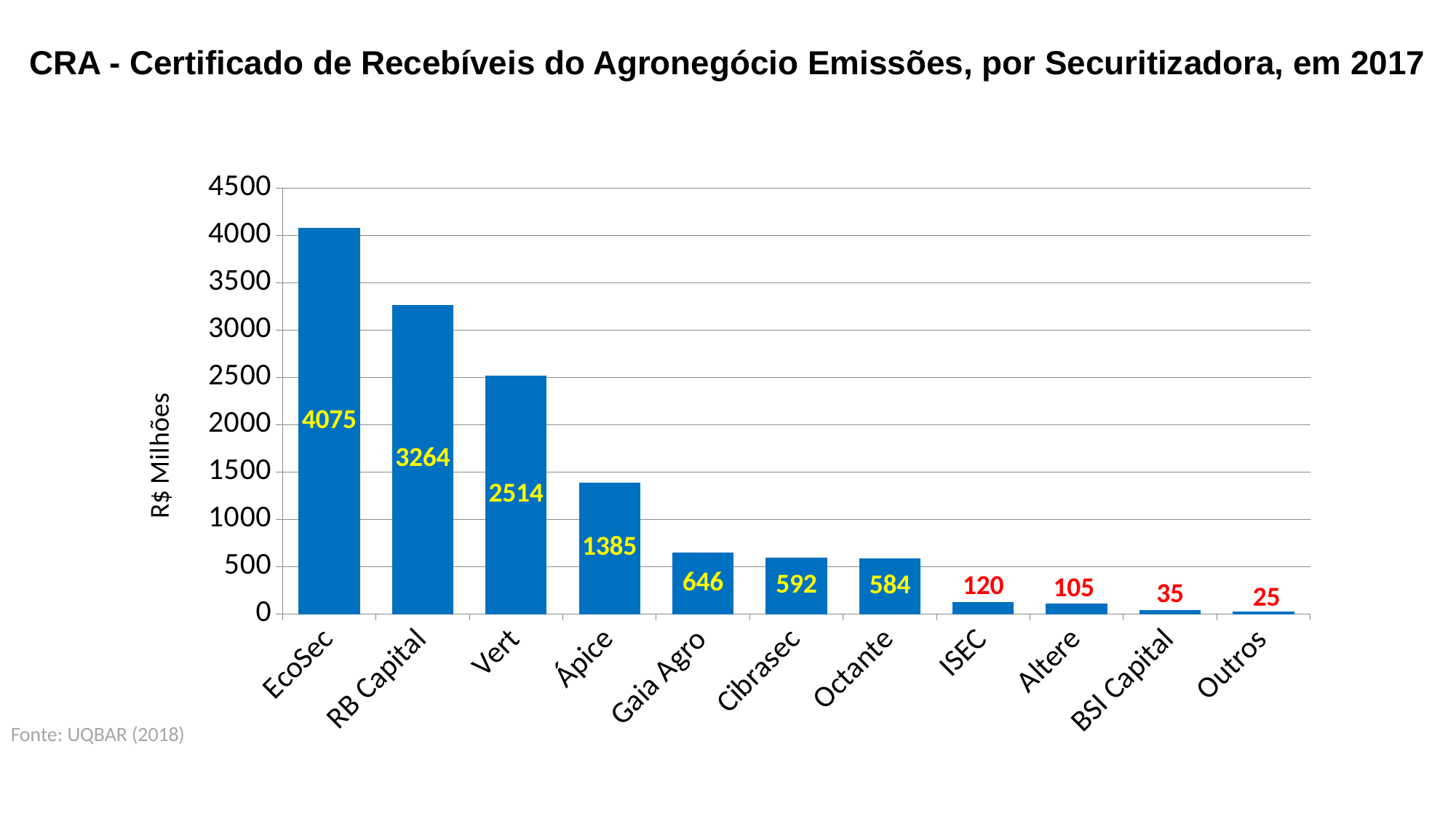
What is the label of the y axis? R$ Milhões Which is larger, the value for Vert or the value for Ápice? Vert What is the difference between the values for ISEC and Altere? 15 Which securitizadora has the highest value? EcoSec What is the value for Gaia Agro? 646 What is the value for BSI Capital? 35 Is the value for Ápice greater or less than 1000? greater What kind of chart is shown on the slide? Bar chart Which securitizadora has the lowest value? Outros How many securitizadoras are shown on the x axis? 11 What is the difference between the values for EcoSec and RB Capital? 811 What is the value for EcoSec? 4075